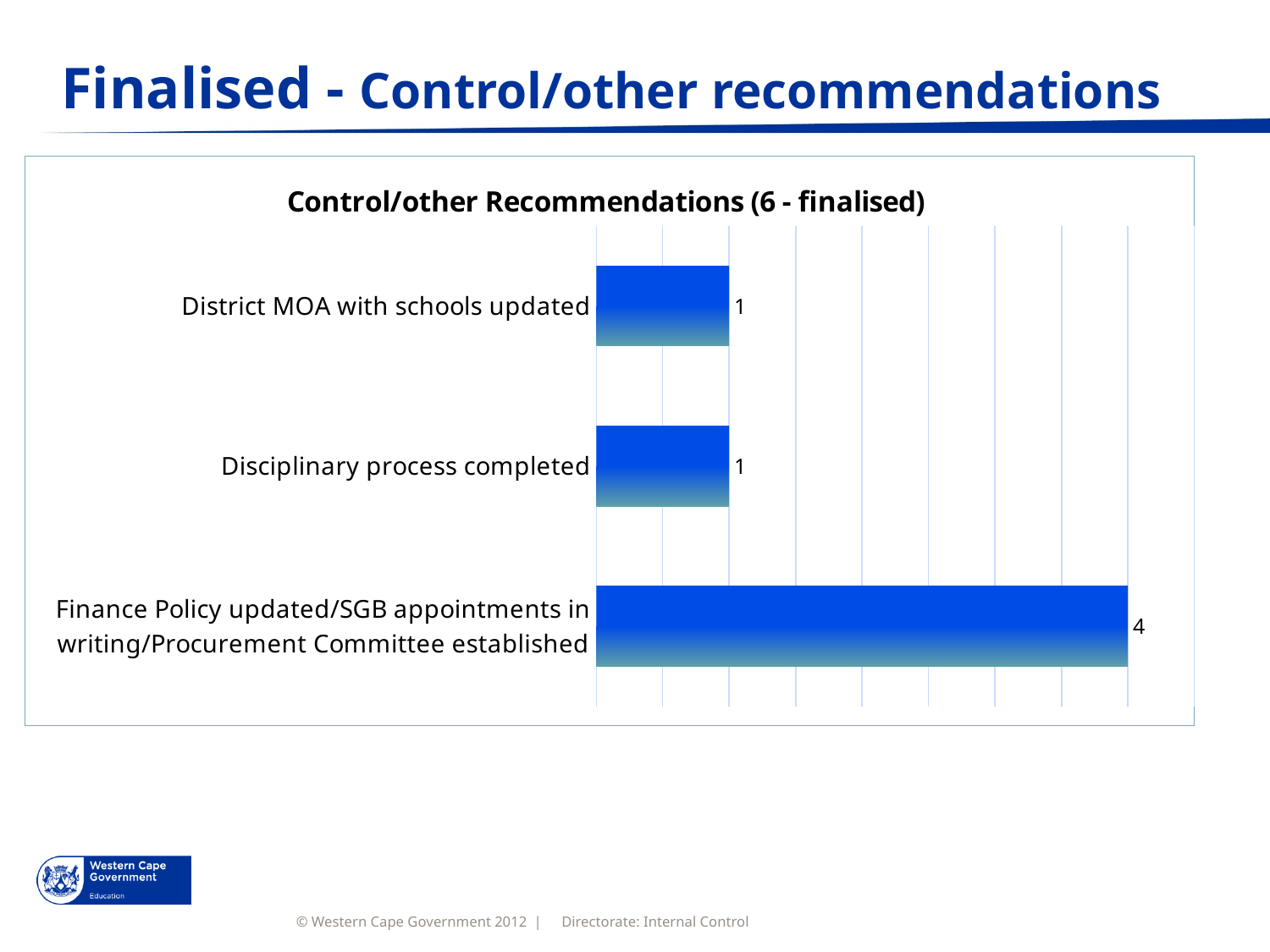
Which category has the highest value? Finance Policy updated/SGB appointments in writing/Procurement Committee established Which is larger: the value for 'District MOA with schools updated' or the value for 'Finance Policy updated/SGB appointments in writing/Procurement Committee established'? Finance Policy updated/SGB appointments in writing/Procurement Committee established What is the value for 'Finance Policy updated/SGB appointments in writing/Procurement Committee established'? 4 What is the total of all the values shown in the chart? 6 What is the difference between the value for 'Finance Policy updated/SGB appointments in writing/Procurement Committee established' and the value for 'Disciplinary process completed'? 3 What is the value for 'Disciplinary process completed'? 1 What kind of chart is shown on the slide? Bar chart What is the value for 'District MOA with schools updated'? 1 How many categories are shown in the chart? 3 Do 'District MOA with schools updated' and 'Disciplinary process completed' have the same value? Yes What is the title of the chart? Control/other Recommendations (6 - finalised)